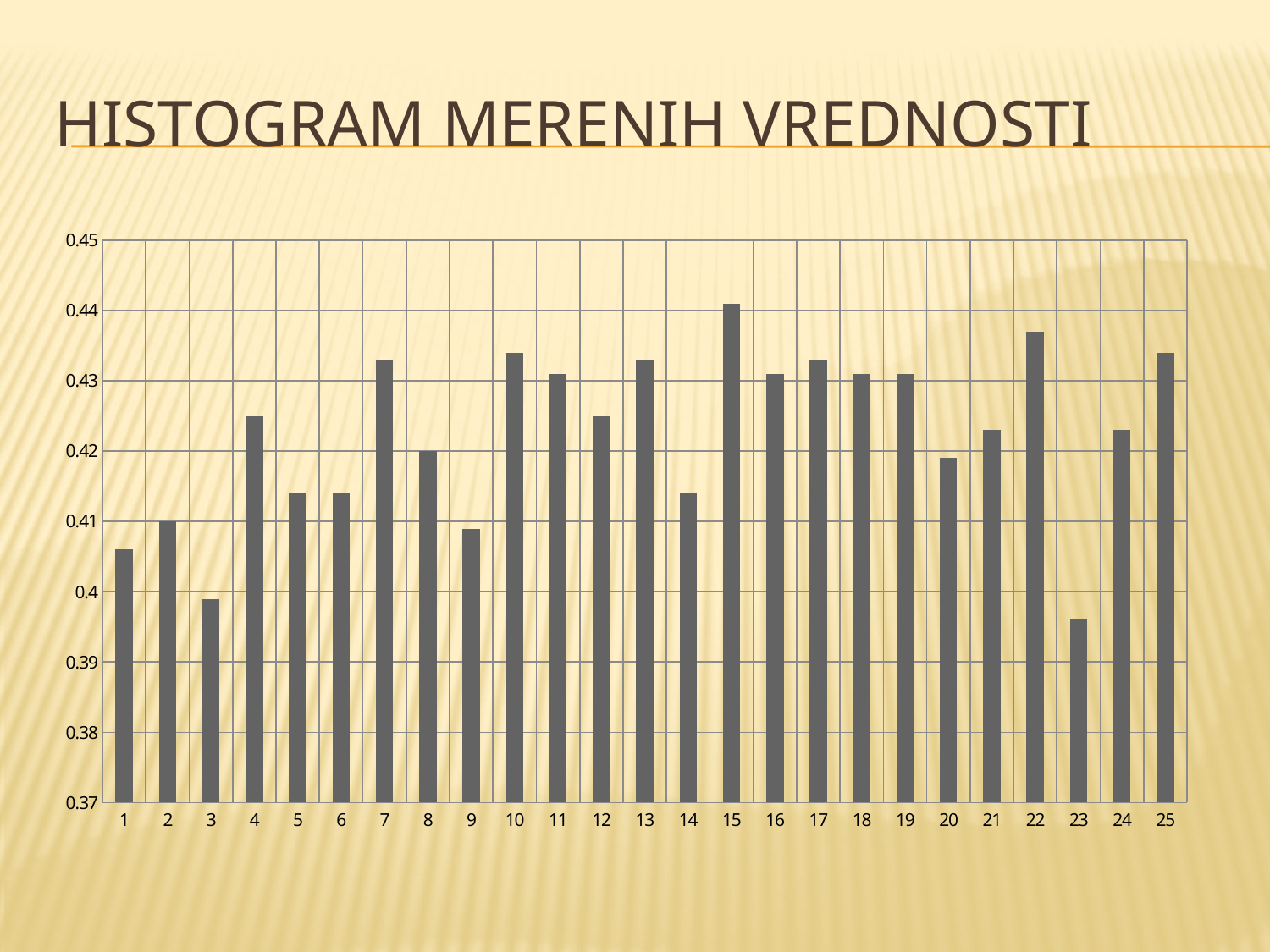
Which is larger, the value for category 15 or the value for category 23? 15 What is the title of the chart on the slide? HISTOGRAM MERENIH VREDNOSTI Is the value for category 1 greater or less than 0.41? less Which category has the highest bar in the chart? 15 Is the value for category 23 greater or less than 0.4? less Is the value for category 22 greater or less than 0.43? greater Which category has the lowest bar in the chart? 23 How many bars are plotted in the chart? 25 What type of chart is shown on the slide? bar chart What is the lowest value shown on the vertical axis of the chart? 0.37 Which is larger, the value for category 3 or the value for category 4? 4